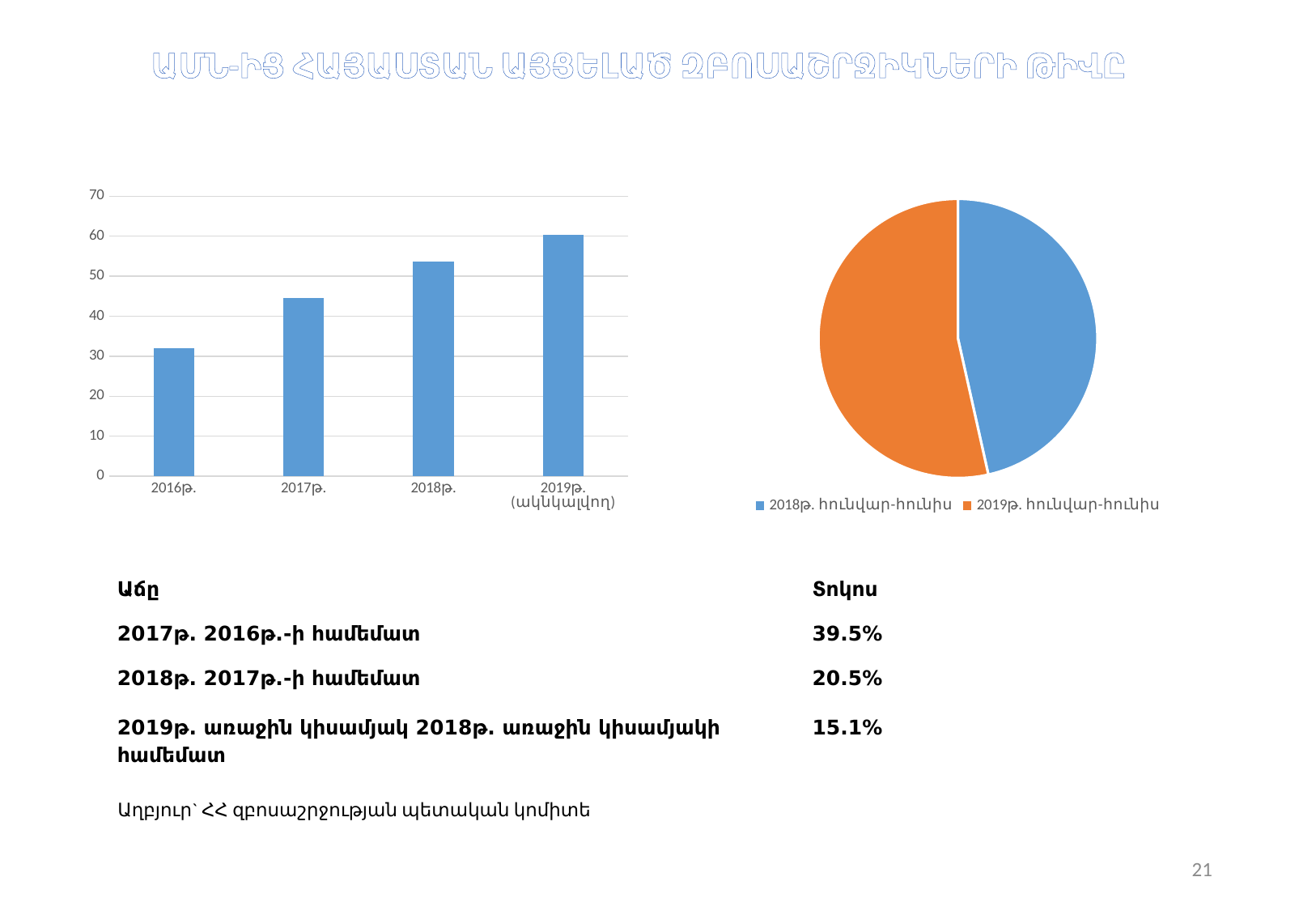
In the pie chart on the right, which legend entry is shown in orange? 2019թ. հունվար-հունիս In the bar chart on the left, is the value for 2018թ. greater or less than 50? greater In the bar chart on the left, is the value for 2016թ. greater or less than 40? less In the pie chart on the right, how many slices are there? 2 In the bar chart on the left, do the values rise or fall from 2016թ. to 2019թ.? rise In the bar chart on the left, which category has the highest bar? 2019թ. (ակնկալվող) What kind of chart is the chart on the left of the slide? bar chart In the bar chart on the left, is the value for 2017թ. greater or less than 40? greater What kind of chart is the chart on the right of the slide? pie chart In the bar chart on the left, how many categories are shown on the x axis? 4 In the bar chart on the left, which category has the lowest bar? 2016թ. In the bar chart on the left, which is larger, the value for 2018թ. or the value for 2016թ.? 2018թ.